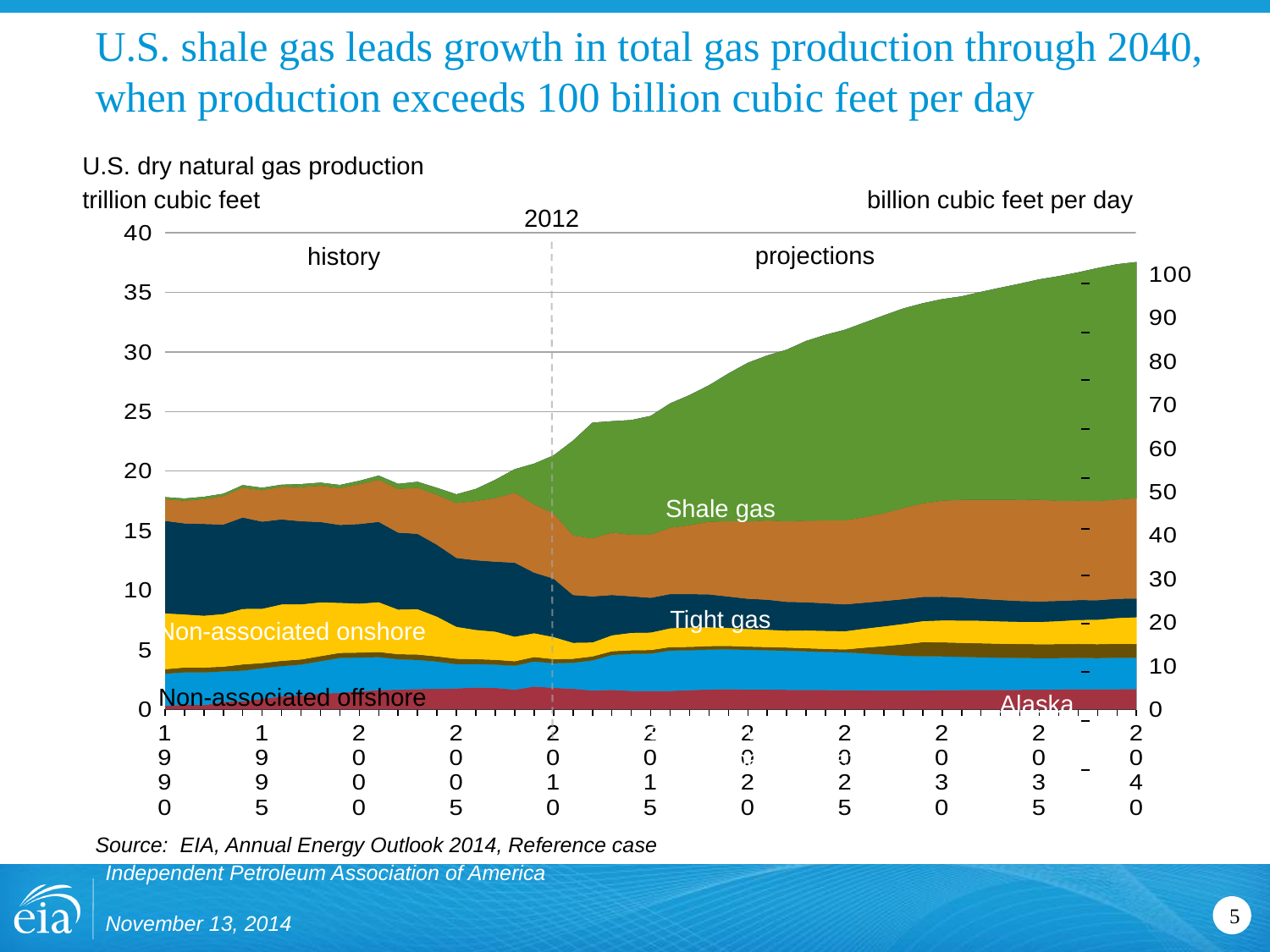
What is the title of the chart? U.S. dry natural gas production What kind of chart is shown on the slide? Stacked area chart What is the first year shown on the x axis? 1990 Is total U.S. dry natural gas production in 1990 greater or less than 20 trillion cubic feet? less What unit is shown on the left vertical axis of the chart? trillion cubic feet What is the last year shown on the x axis? 2040 Is total U.S. dry natural gas production in 2012 greater or less than 20 trillion cubic feet? greater What year does the dashed vertical line separating history from projections mark? 2012 Is total U.S. dry natural gas production in 2040 greater or less than 35 trillion cubic feet? greater Which labeled source accounts for the largest share of production in 2040? Shale gas Does total U.S. dry natural gas production rise or fall between 2012 and 2040? rise